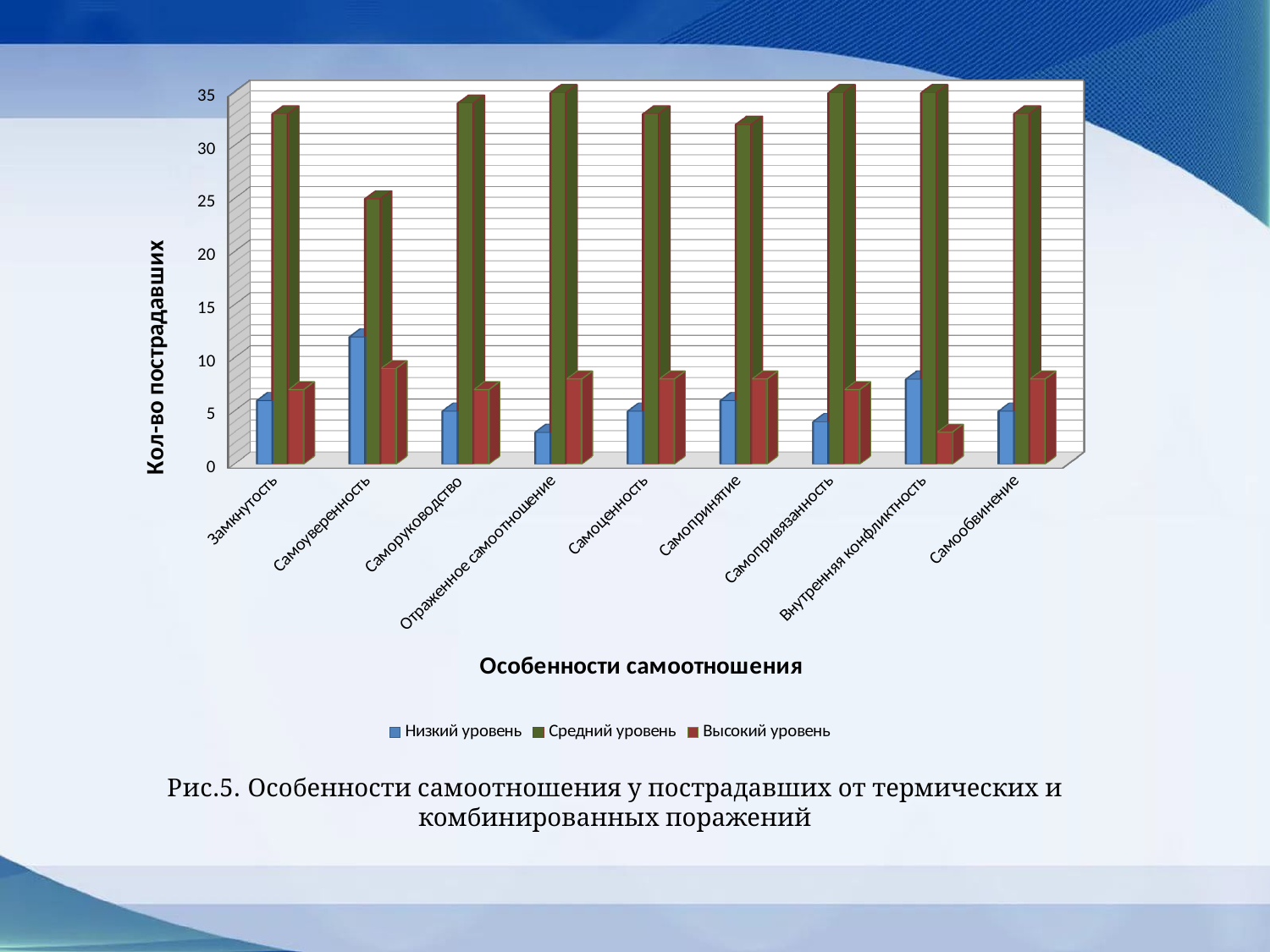
What is the title of the vertical axis? Кол-во пострадавших Is the value for Низкий уровень in Самоуверенность greater or less than 10? greater What kind of chart is shown on the slide? bar chart Is the value for Высокий уровень in Внутренняя конфликтность greater or less than 5? less How many categories are shown on the x axis? 9 Which category has the lowest value for Средний уровень? Самоуверенность Which category has the lowest value for Высокий уровень? Внутренняя конфликтность Which category has the highest value for Низкий уровень? Самоуверенность For Внутренняя конфликтность, which is larger: Низкий уровень or Высокий уровень? Низкий уровень Which is larger: Средний уровень for Замкнутость or Средний уровень for Самоуверенность? Замкнутость How many series does the legend list? 3 Is the value for Средний уровень in Самоуверенность greater or less than 30? less